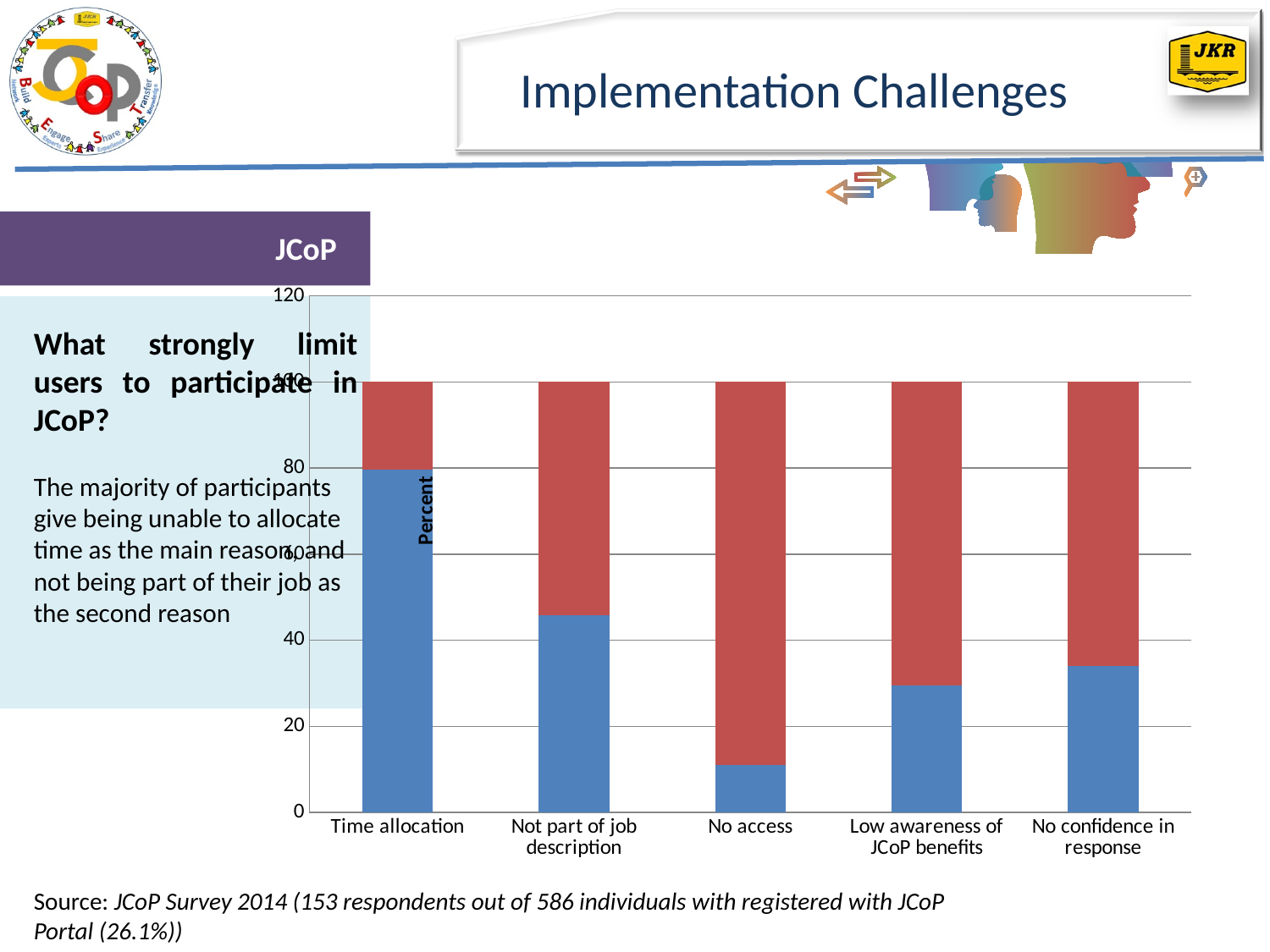
Which category has the shortest blue segment? No access Which category has the tallest blue segment? Time allocation How many categories are shown on the x axis of the chart? 5 Is the blue segment for Low awareness of JCoP benefits greater or less than 40? less What kind of chart is shown on the slide? stacked bar chart Is the blue segment for No access greater or less than 20? less Which has a larger blue segment: Not part of job description or No confidence in response? Not part of job description What is the highest value shown on the vertical axis of the chart? 120 What is the label on the vertical axis of the chart? Percent Is the blue segment for Time allocation greater or less than 60? greater Which has a larger blue segment: No access or Low awareness of JCoP benefits? Low awareness of JCoP benefits